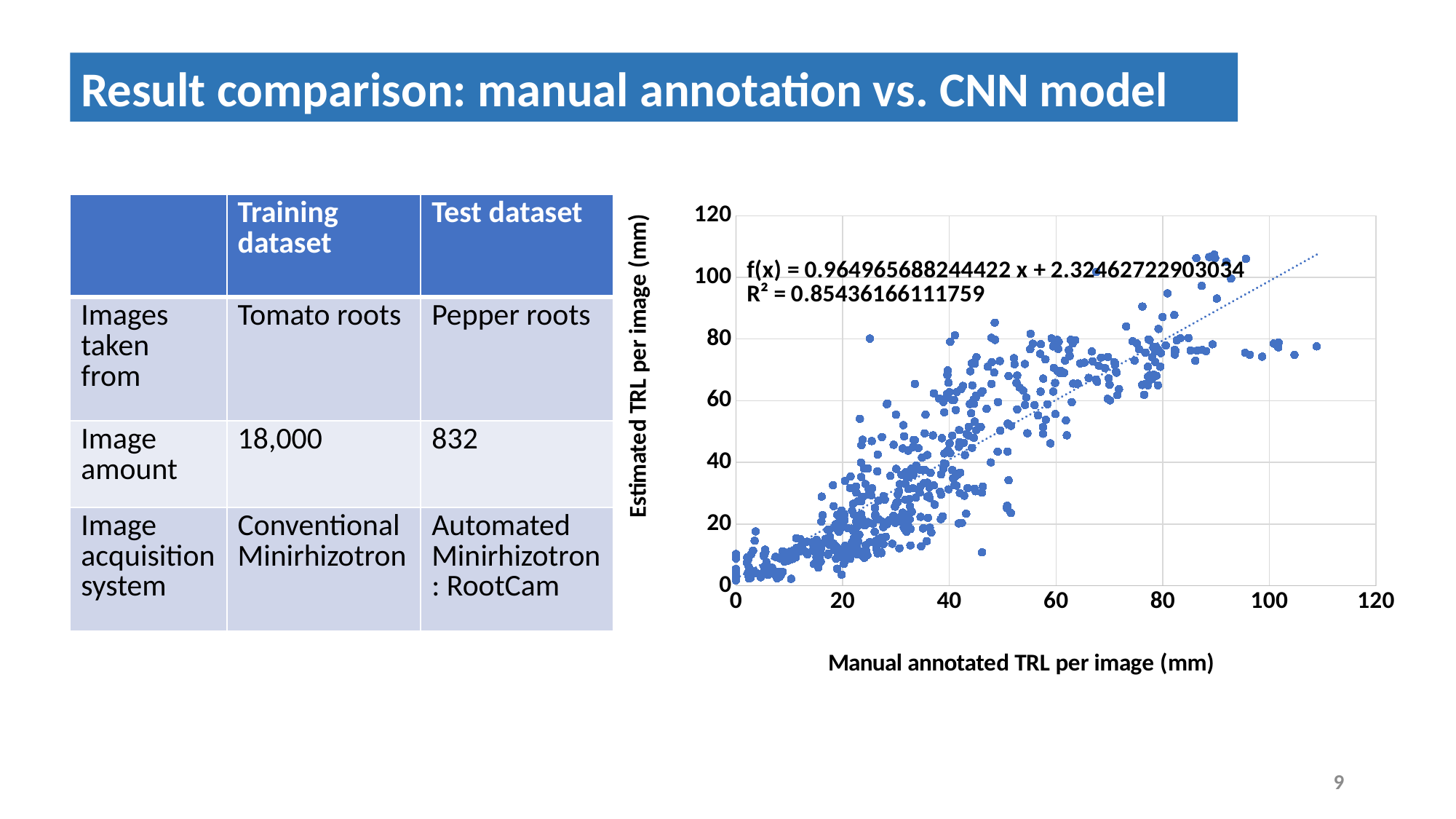
What is the highest tick value shown on the y axis? 120 What R² value is printed on the chart? 0.85436166111759 Is the slope of the fitted line printed on the chart greater or less than 1? less Is the R² value printed on the chart greater or less than 0.8? greater What is the title of the y axis of the chart? Estimated TRL per image (mm) Is the estimated TRL of the highest point on the chart greater or less than 100? greater Do the estimated TRL values generally rise or fall as the manual annotated TRL increases along the x axis? rise What kind of chart is shown on the slide? scatter chart What is the title of the x axis of the chart? Manual annotated TRL per image (mm) What is the intercept of the fitted line f(x) printed on the chart? 2.32462722903034 What is the slope of the fitted line f(x) printed on the chart? 0.964965688244422